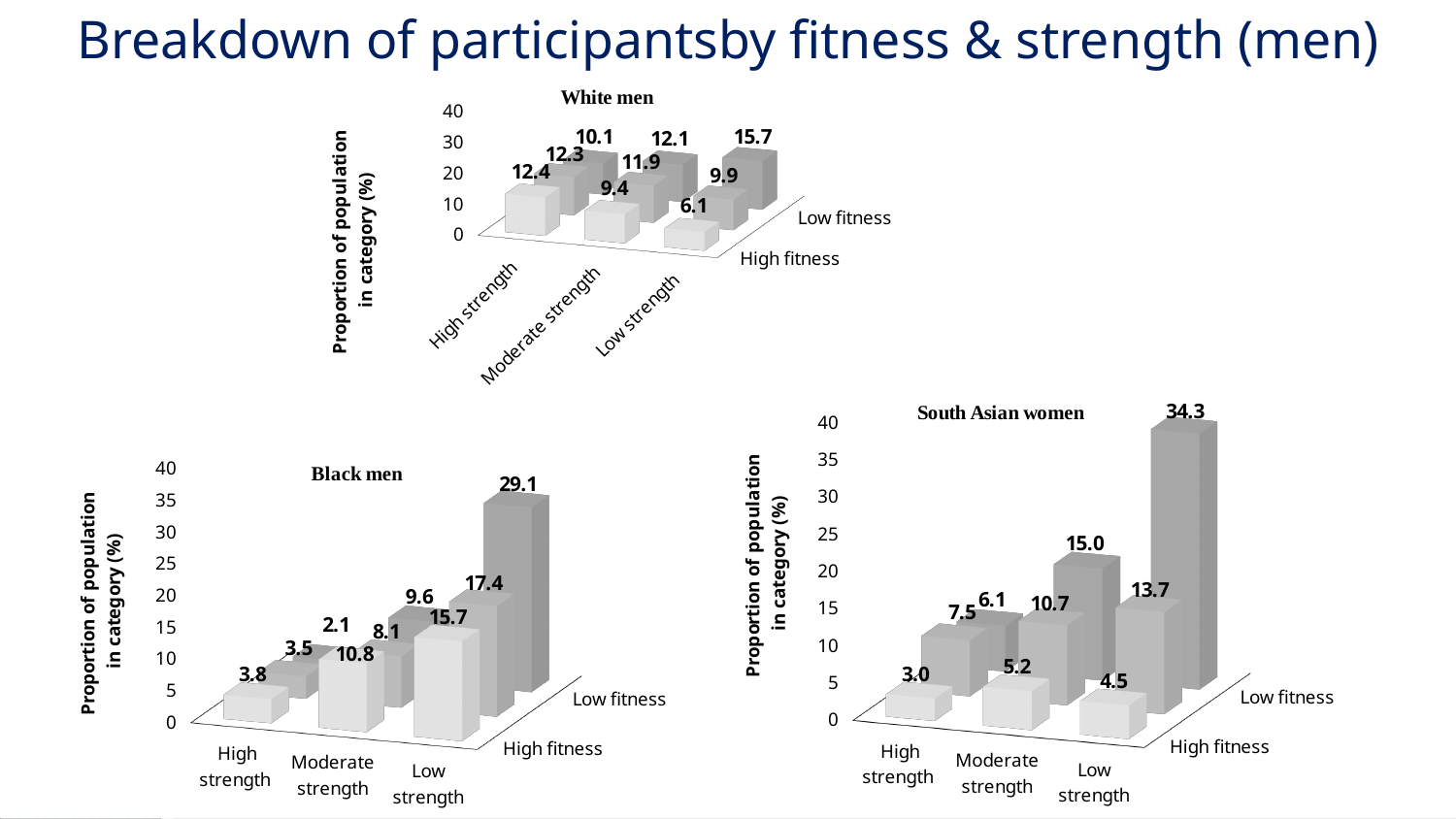
In the White men chart, what is the value for High strength at High fitness? 12.4 What kind of chart is the South Asian women chart? bar chart In the South Asian women chart, what is the highest value shown? 34.3 In the Black men chart, do the Low fitness values rise or fall going from High strength to Low strength? rise In the Black men chart, what is the difference between the Low strength values at Low fitness and at High fitness? 13.4 In the South Asian women chart, what is the value for Moderate strength at High fitness? 5.2 In the South Asian women chart, is the value for Low strength at Low fitness greater or less than 30? greater How many strength categories are shown on the x axis of the Black men chart? 3 In the White men chart, at High fitness, which is larger: High strength or Low strength? High strength In the White men chart, what is the value for Low strength at Low fitness? 15.7 In the Black men chart, what is the value for High strength at High fitness? 3.8 In the Black men chart, which strength and fitness combination has the highest value? Low strength, Low fitness